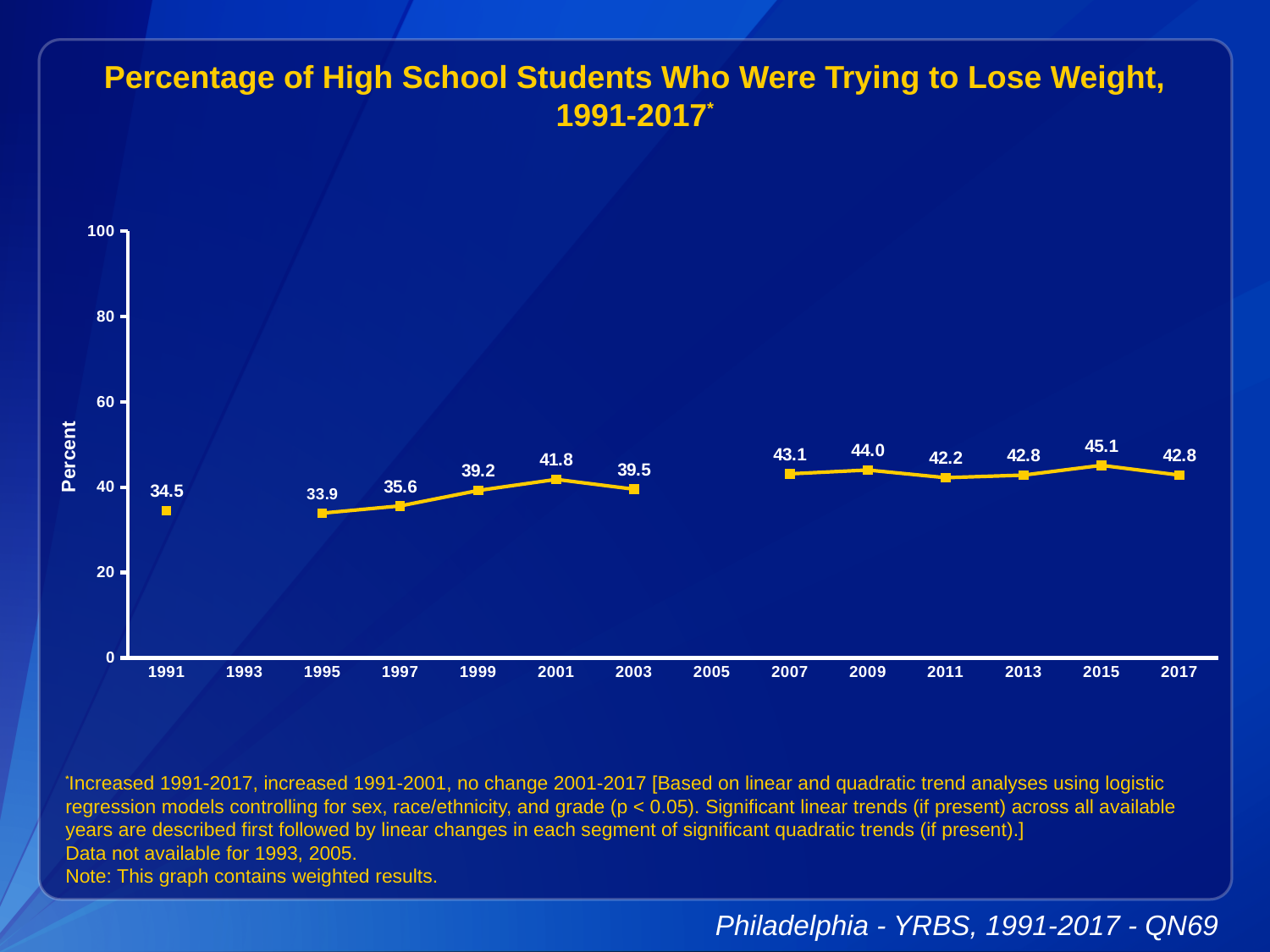
What value is shown for 2009? 44.0 What kind of chart is shown on the slide? Line chart Which year has the lowest percentage of students trying to lose weight? 1995 How many years have data points plotted on the chart? 12 Did the percentage rise or fall from 1995 to 2001? Rise Which year has a higher value, 2001 or 2003? 2001 Which year has the highest percentage of students trying to lose weight? 2015 What is the difference between the values for 2015 and 1991? 10.6 What is the label on the y axis? Percent What was the percentage of high school students trying to lose weight in 2017? 42.8 What was the percentage of high school students trying to lose weight in 1991? 34.5 Is the value for 2007 greater or less than 40? greater